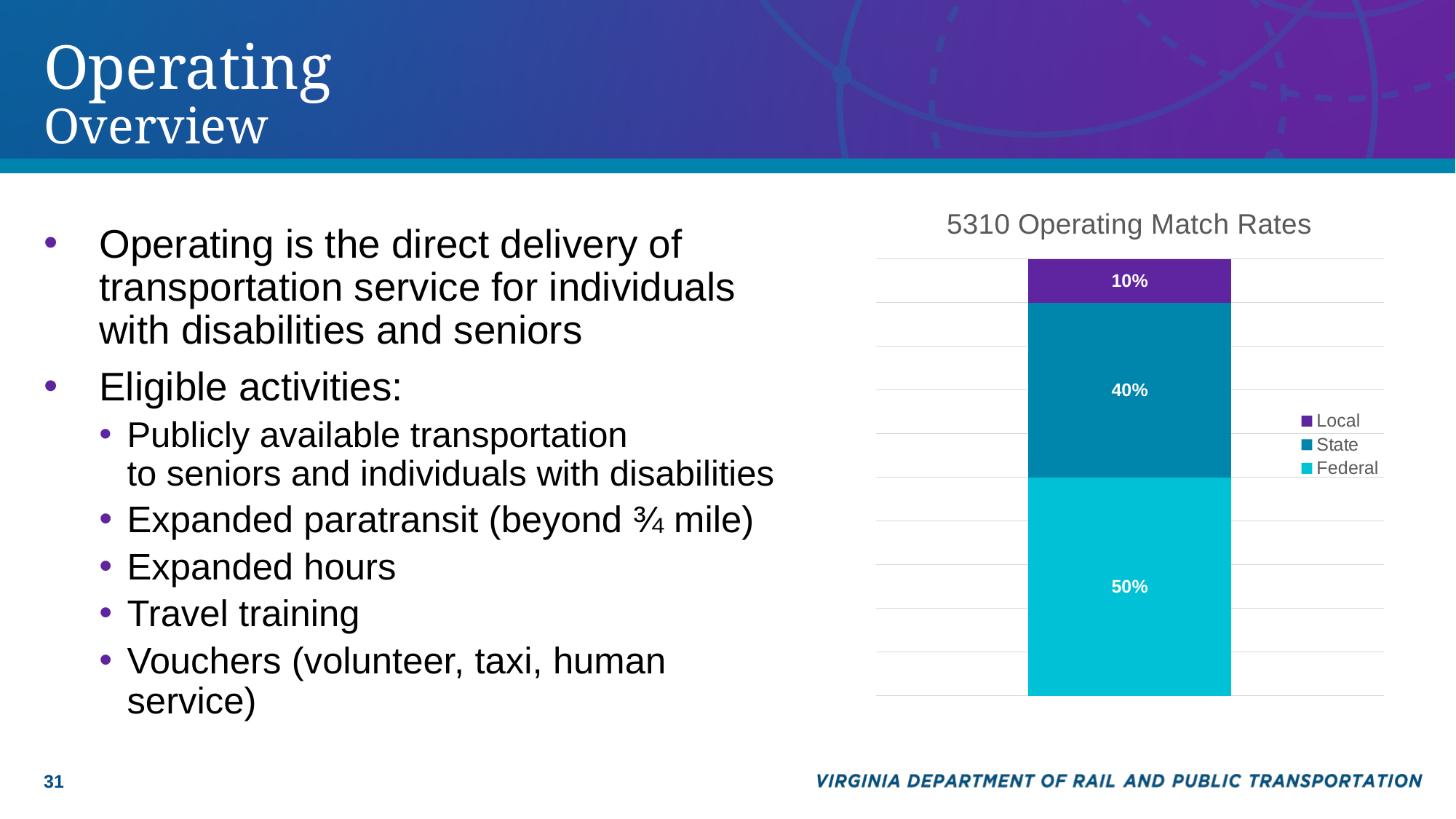
How many series does the legend of the 5310 Operating Match Rates chart list? 3 What is the difference between the Federal and State shares in the 5310 Operating Match Rates chart? 10% What is the total of the stacked bar in the 5310 Operating Match Rates chart? 100% Which is larger in the 5310 Operating Match Rates chart, the State share or the Local share? State What is the Local share shown in the 5310 Operating Match Rates chart? 10% What is the Federal share shown in the 5310 Operating Match Rates chart? 50% What is the State share shown in the 5310 Operating Match Rates chart? 40% What kind of chart is the 5310 Operating Match Rates chart? Stacked bar chart Which series has the smallest share in the 5310 Operating Match Rates chart? Local What is the title of the chart on the slide? 5310 Operating Match Rates Which series has the largest share in the 5310 Operating Match Rates chart? Federal What is the difference between the State and Local shares in the 5310 Operating Match Rates chart? 30%